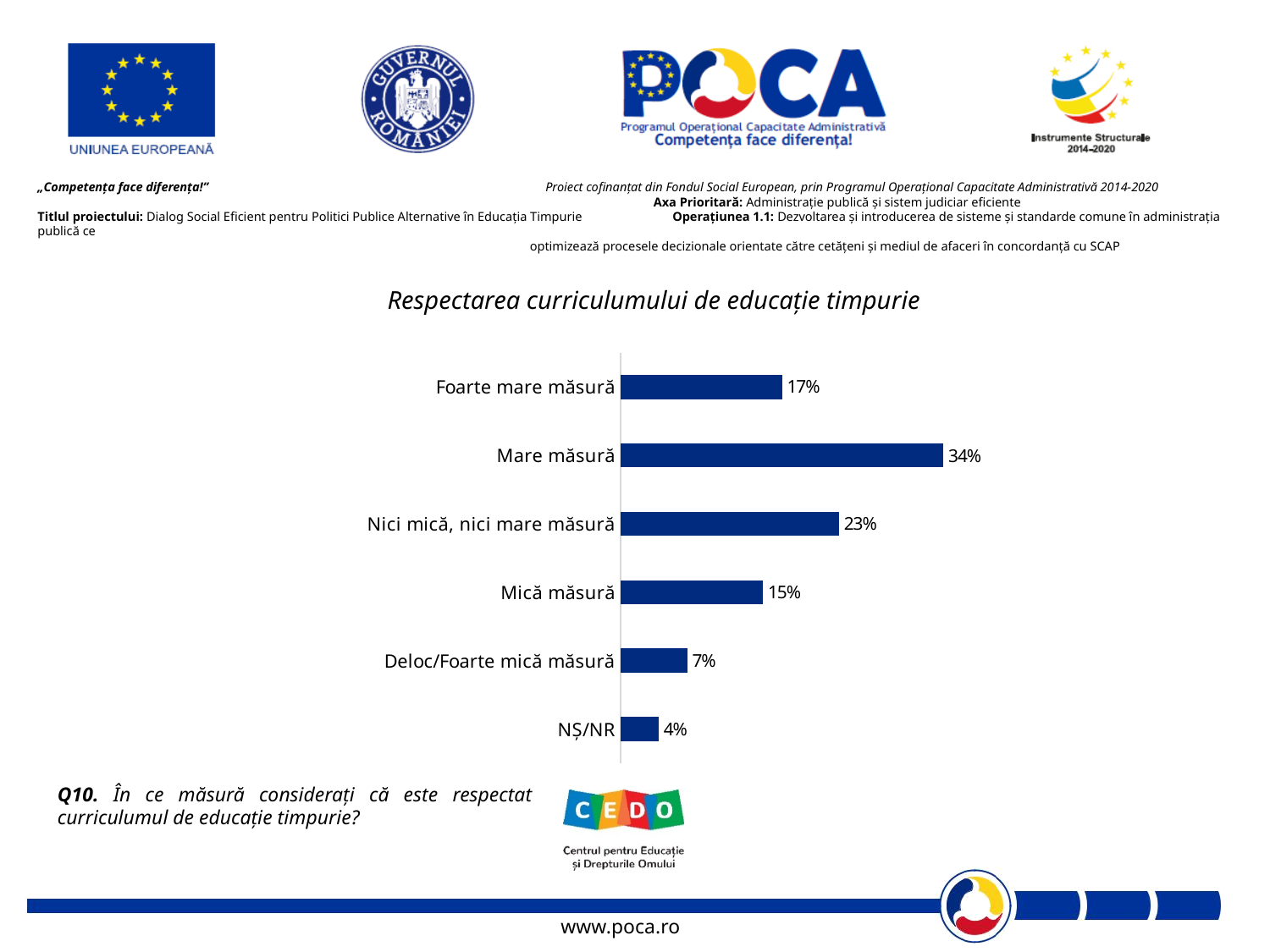
What is the difference between the values for "Mare măsură" and "Foarte mare măsură"? 17% What is the value for "NȘ/NR"? 4% How many categories are shown in the chart? 6 Which category has the highest value? Mare măsură Which is larger, the value for "Foarte mare măsură" or the value for "Mică măsură"? Foarte mare măsură What is the value for "Mică măsură"? 15% What is the value for "Nici mică, nici mare măsură"? 23% What is the title of the chart? Respectarea curriculumului de educație timpurie What is the difference between the values for "Deloc/Foarte mică măsură" and "NȘ/NR"? 3% Which category has the lowest value? NȘ/NR What kind of chart is shown on the slide? Bar chart What is the value for "Mare măsură"? 34%